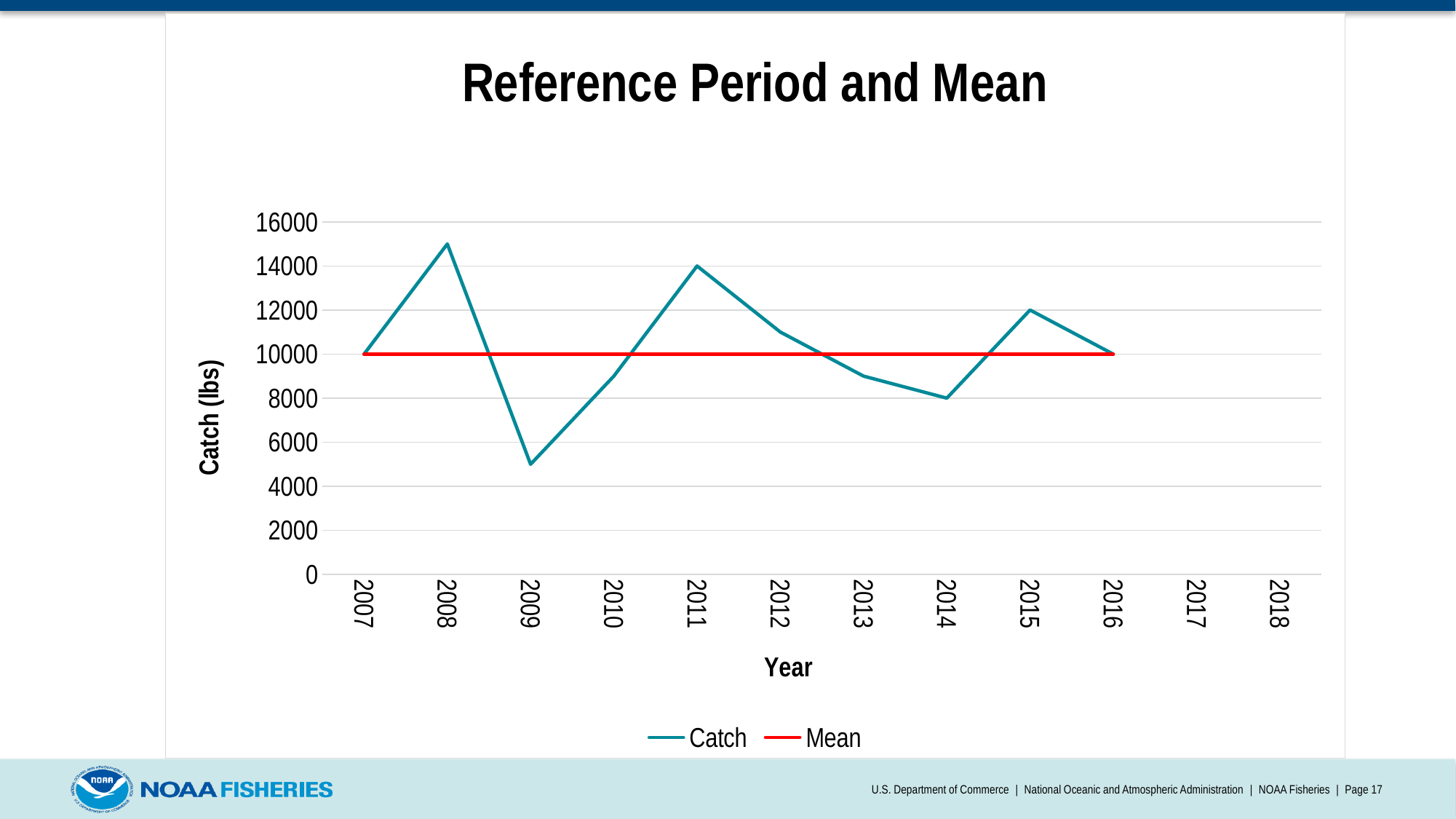
Which is larger, the Catch value for 2011 or for 2015? 2011 Which year has the lowest Catch value? 2009 How many series does the legend list? 2 What is the Catch value for 2014? 8000 Does the Catch value rise or fall from 2011 to 2014? fall What is the Catch value for 2011? 14000 Which year has the highest Catch value? 2008 Is the Catch value for 2008 greater or less than 14000? greater What is the value of the Mean line? 10000 Is the Catch value for 2009 greater or less than 6000? less What type of chart is shown on the slide? line chart What is the difference between the Catch values for 2011 and 2014? 6000